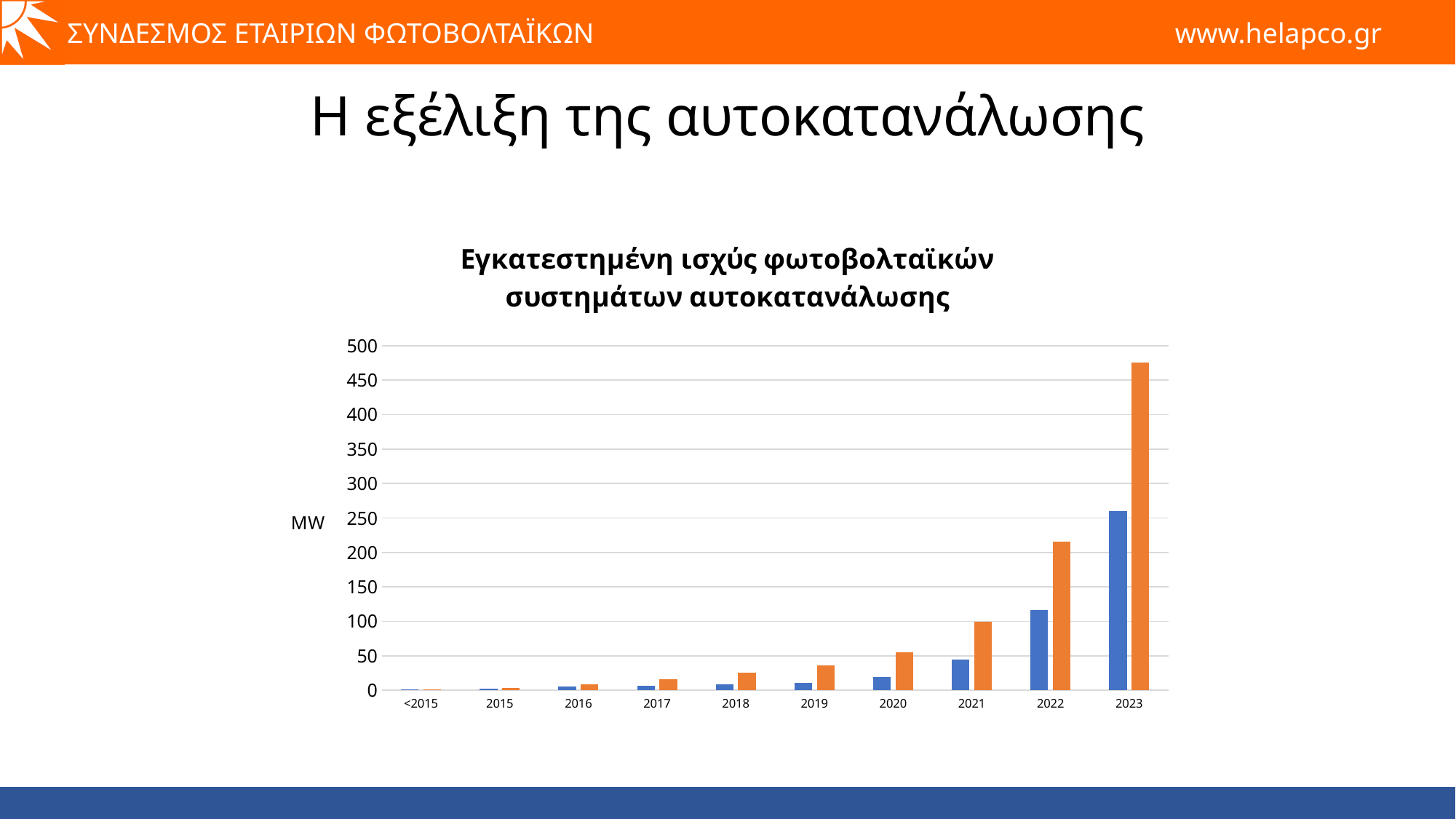
Which category has the lowest bars in the chart? <2015 Is the value of the orange bar for 2023 greater or less than 450? greater What is the title of the chart? Εγκατεστημένη ισχύς φωτοβολταϊκών συστημάτων αυτοκατανάλωσης How many year categories are shown on the x axis of the chart? 10 Is the value of the blue bar for 2023 greater or less than 200? greater Is the value of the blue bar for 2021 greater or less than 50? less Do the bar values rise or fall from <2015 to 2023? rise What kind of chart is shown on the slide? bar chart Which year has the tallest bar in the chart? 2023 What unit is shown on the vertical axis of the chart? MW In 2023, which bar is larger, the blue one or the orange one? the orange one